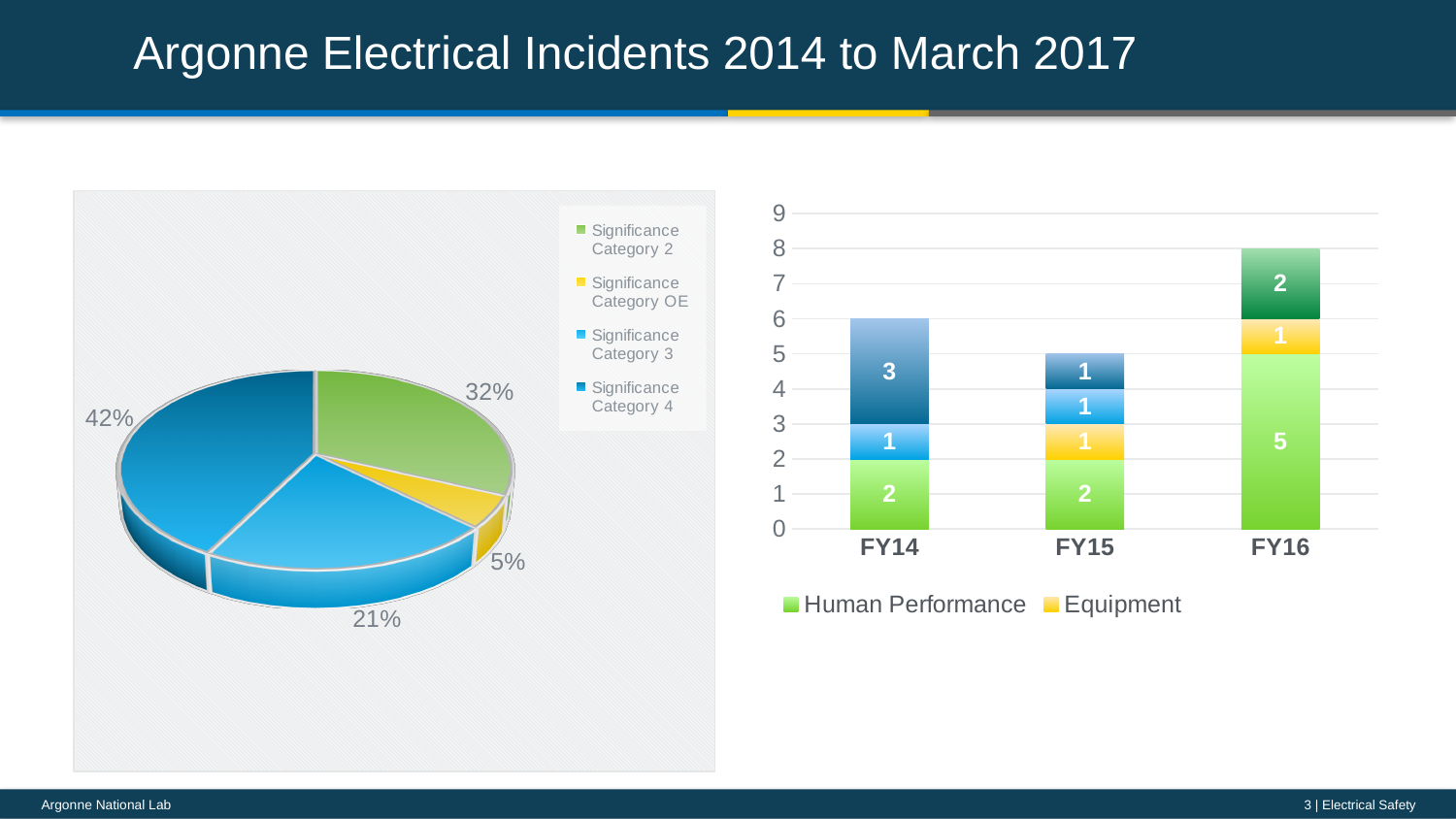
In the bar chart on the right, what is the Human Performance value for FY16? 5 In the bar chart on the right, what is the total height of the stacked bar for FY14? 6 How many fiscal years are shown on the x axis of the bar chart on the right? 3 In the pie chart on the left, which significance category has the largest slice? Significance Category 4 In the pie chart on the left, what share of incidents is Significance Category 2? 32% In the bar chart on the right, what is the Equipment value for FY15? 1 What kind of chart is the chart on the left of the slide? Pie chart How many slices does the pie chart on the left have? 4 In the bar chart on the right, what is the total height of the stacked bar for FY16? 8 In the bar chart on the right, how much larger is the Human Performance value for FY16 than for FY14? 3 In the pie chart on the left, which significance category has the smallest slice? Significance Category OE In the pie chart on the left, what share of incidents is Significance Category 4? 42%